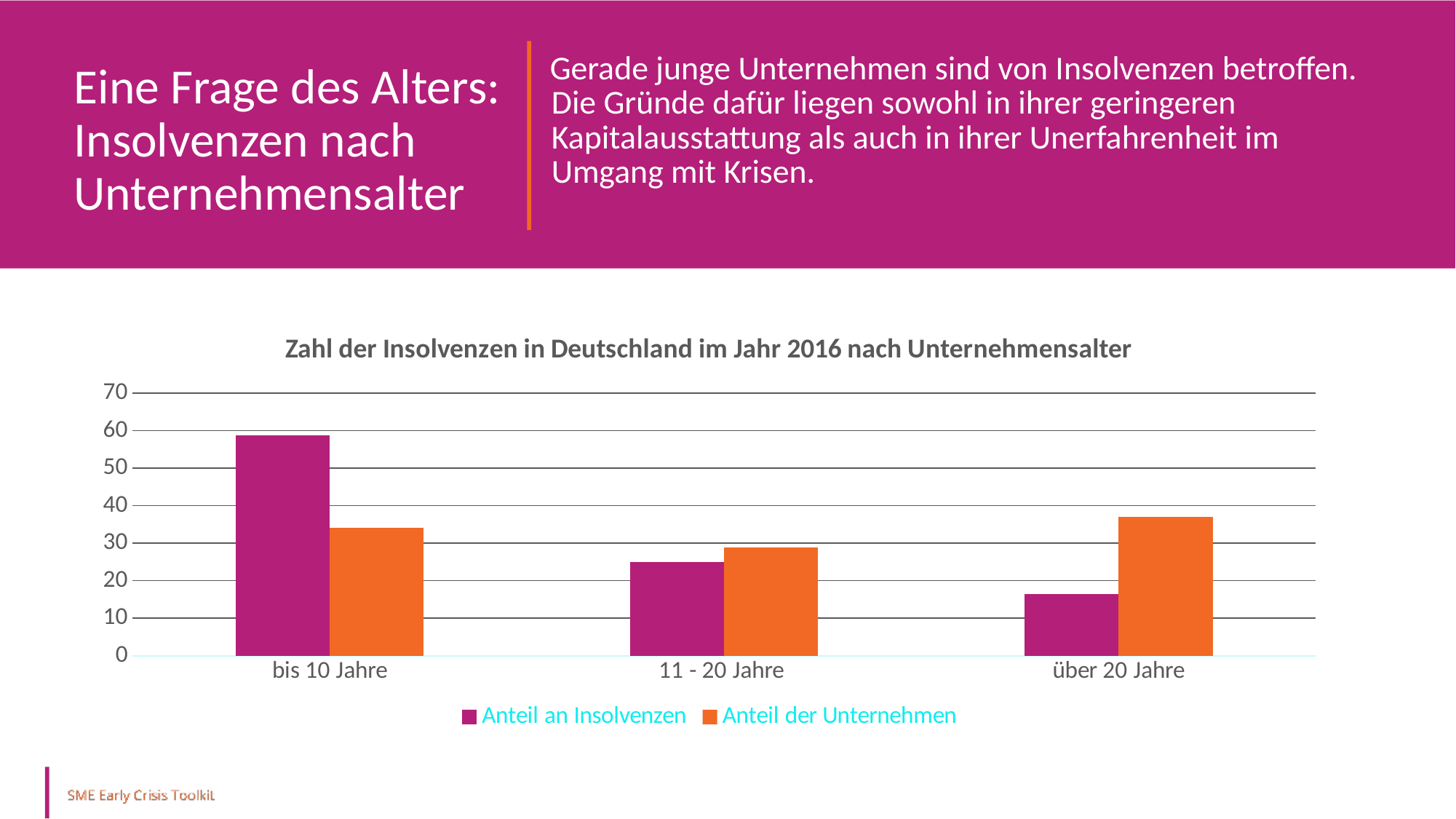
Is the value for Anteil der Unternehmen for über 20 Jahre greater or less than 40? less How many series does the chart legend list? 2 Which category has the highest value for Anteil an Insolvenzen? bis 10 Jahre What is the title of the chart? Zahl der Insolvenzen in Deutschland im Jahr 2016 nach Unternehmensalter What kind of chart is shown on the slide? bar chart Which category has the lowest value for Anteil an Insolvenzen? über 20 Jahre Which category has the lowest value for Anteil der Unternehmen? 11 - 20 Jahre Is the value for Anteil an Insolvenzen for über 20 Jahre greater or less than 20? less Is the value for Anteil an Insolvenzen for bis 10 Jahre greater or less than 50? greater How many age categories are shown on the x axis of the chart? 3 Do the values for Anteil an Insolvenzen rise or fall from bis 10 Jahre to über 20 Jahre? fall For über 20 Jahre, which is larger: Anteil an Insolvenzen or Anteil der Unternehmen? Anteil der Unternehmen